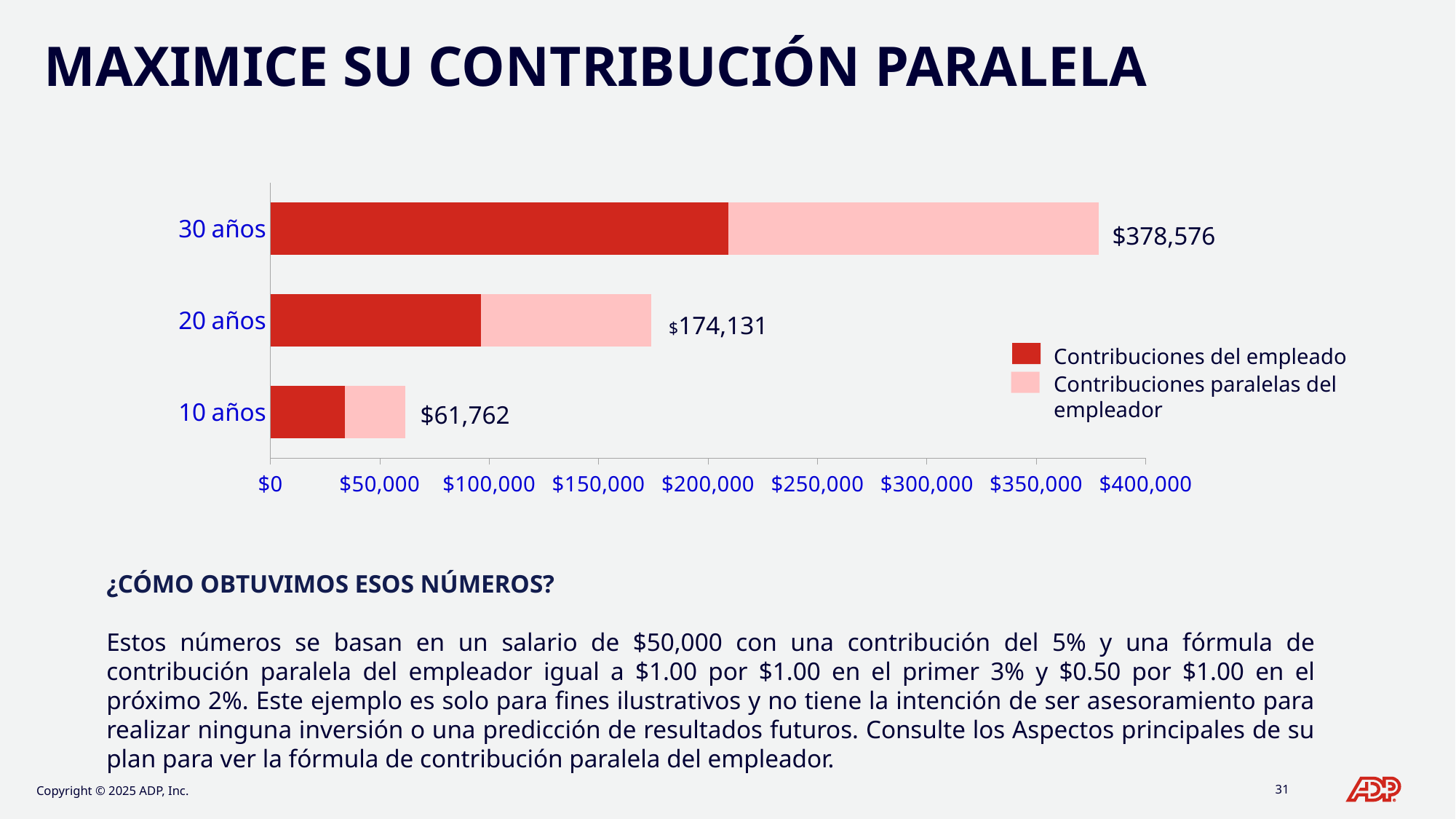
Which category has the lowest total? 10 años What is the total labeled for the 10 años bar? $61,762 Is the Contribuciones del empleado value for 30 años greater or less than $200,000? greater What is the total labeled for the 20 años bar? $174,131 How many series does the legend list? 2 Which is larger, the total for 20 años or the total for 10 años? 20 años What is the difference between the 20 años total and the 10 años total? $112,369 What is the total labeled for the 30 años bar? $378,576 How many categories are shown on the chart? 3 What is the difference between the 30 años total and the 20 años total? $204,445 Is the Contribuciones del empleado value for 10 años greater or less than $50,000? less Which category has the highest total? 30 años